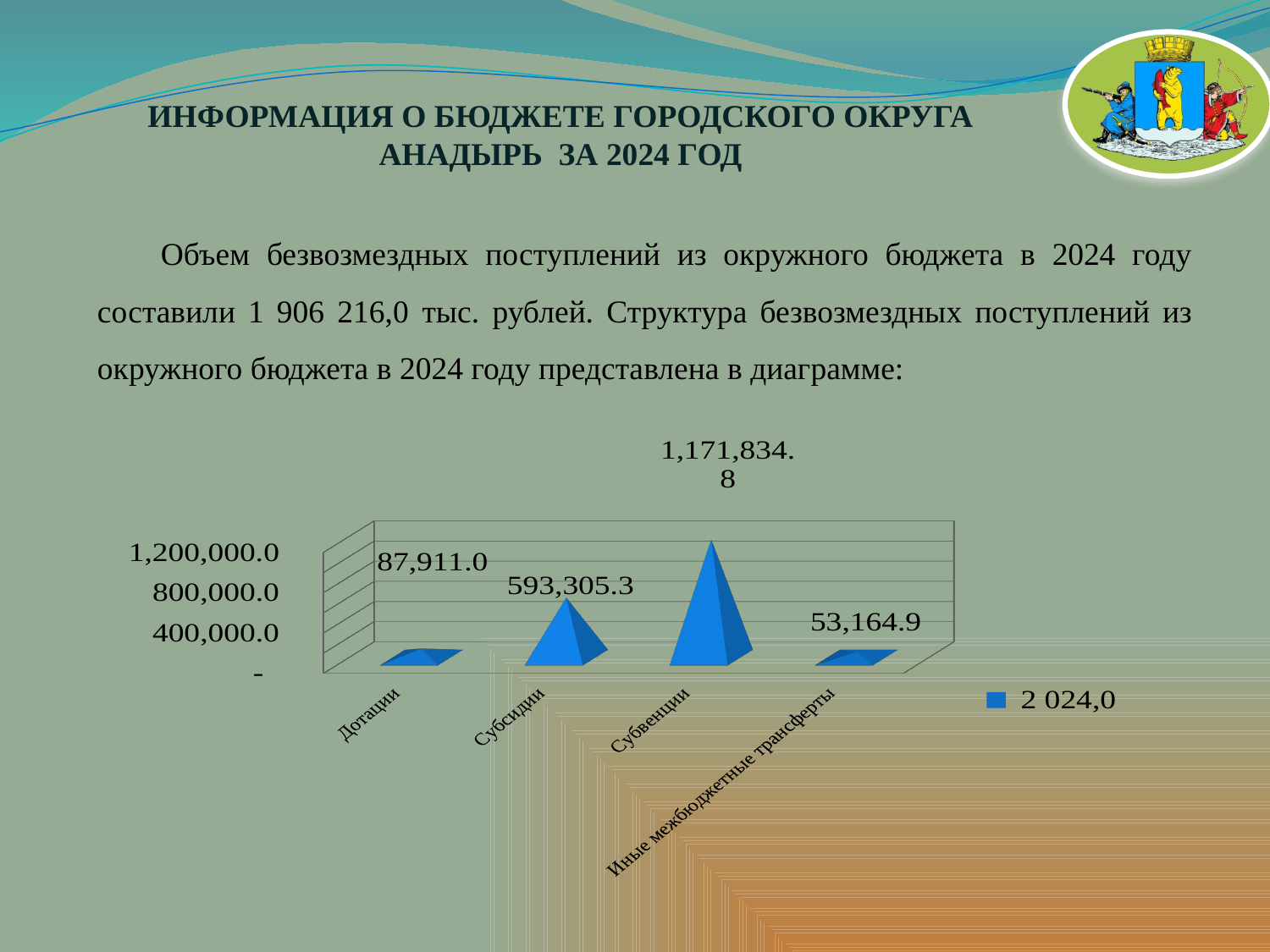
What is the value for Субвенции? 1,171,834.8 How many series does the legend list? 1 Is the value for Субсидии greater or less than 400,000.0? greater What is the value for Иные межбюджетные трансферты? 53,164.9 How many categories are shown on the x axis? 4 Which category has the lowest value? Иные межбюджетные трансферты What is the difference between the values for Субвенции and Субсидии? 578,529.5 What is the value for Субсидии? 593,305.3 What is the legend entry for the series shown? 2 024,0 Which category has the highest value? Субвенции What is the value for Дотации? 87,911.0 Which is larger, the value for Дотации or the value for Иные межбюджетные трансферты? Дотации